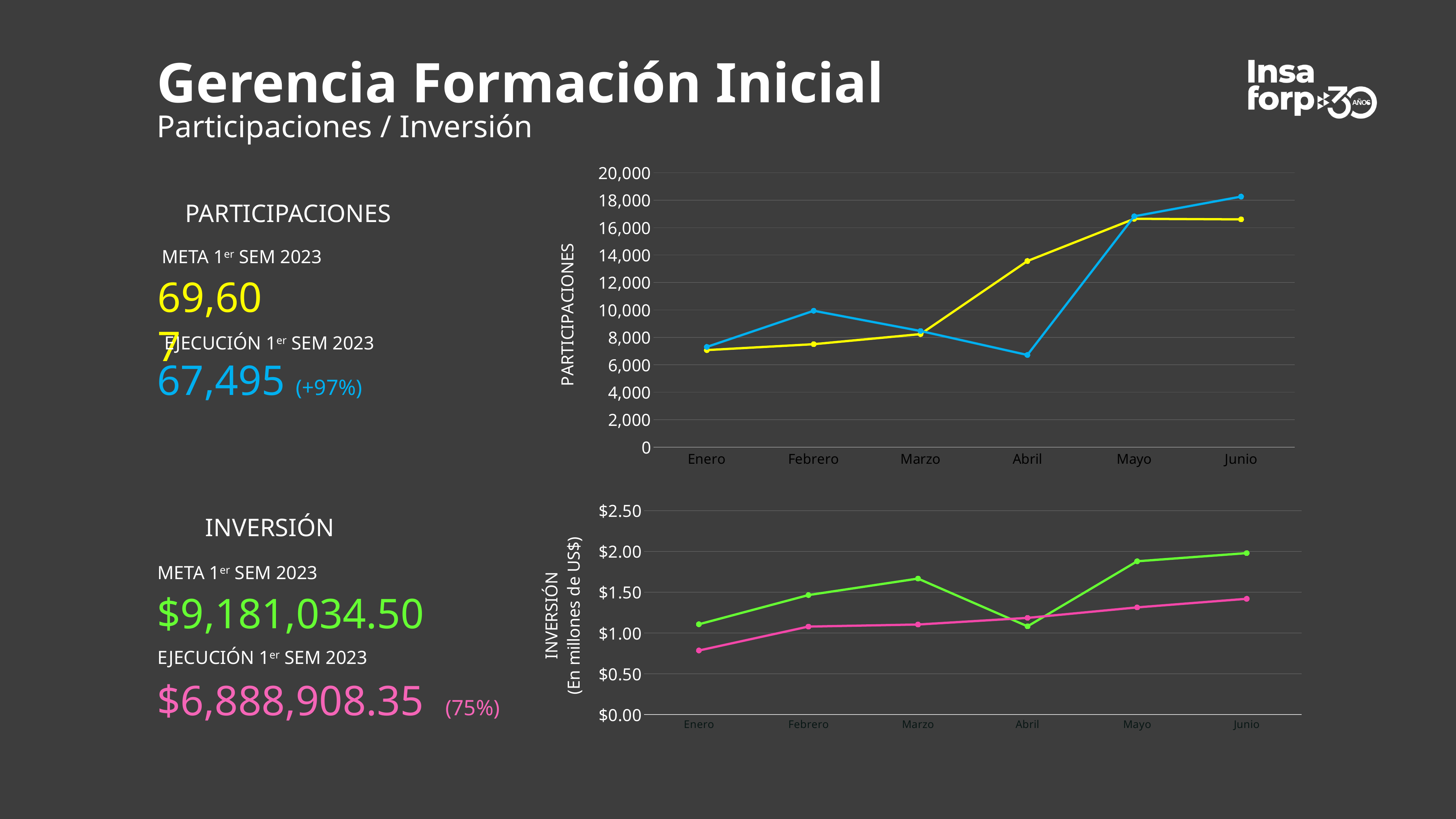
In the bottom chart (INVERSIÓN), is the value of the pink line for Enero greater or less than $1.00? less In the bottom chart (INVERSIÓN), does the pink line rise or fall from Enero to Junio? rise What is the y-axis label of the bottom chart? INVERSIÓN (En millones de US$) How many lines are plotted in the top chart (PARTICIPACIONES)? 2 In the top chart (PARTICIPACIONES), in which month does the blue line reach its highest value? Junio In the bottom chart (INVERSIÓN), which line is higher in Marzo, the green line or the pink line? the green line In the top chart (PARTICIPACIONES), is the value of the blue line for Abril greater or less than 8,000? less What kind of chart is the top chart (PARTICIPACIONES)? line chart How many months are shown on the x axis of the top chart (PARTICIPACIONES)? 6 In the top chart (PARTICIPACIONES), is the value of the yellow line for Abril greater or less than 12,000? greater In the top chart (PARTICIPACIONES), which line is higher in Febrero, the blue line or the yellow line? the blue line In the top chart (PARTICIPACIONES), in which month does the blue line reach its lowest value? Abril